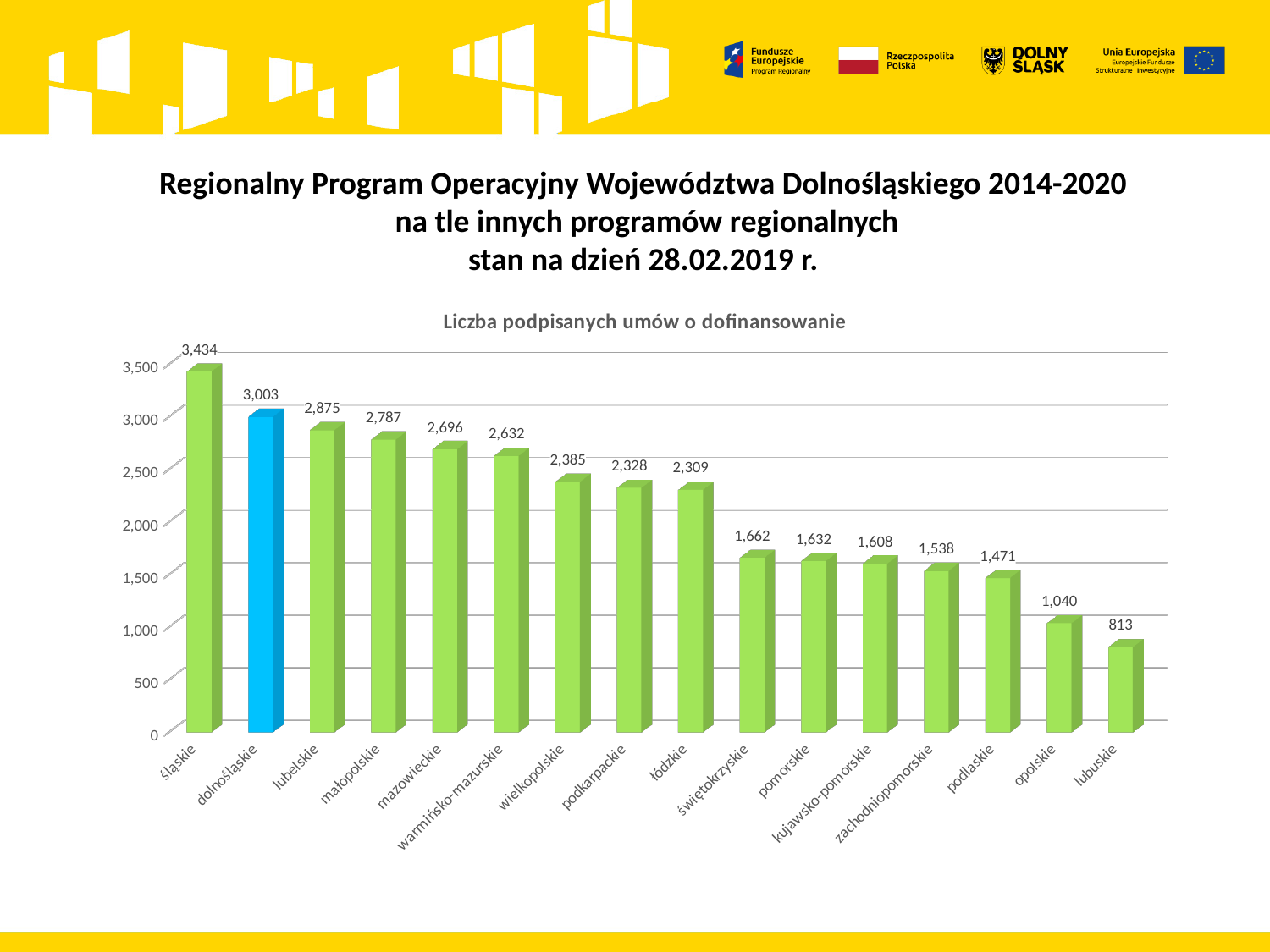
What is the difference between the values for śląskie and dolnośląskie? 431 What kind of chart is shown on the slide? bar chart Which is larger, the value for pomorskie or the value for zachodniopomorskie? pomorskie Which category has the highest value? śląskie Which category has the lowest value? lubuskie Is the value for mazowieckie greater or less than 2,500? greater How many categories are shown on the x axis? 16 What is the value for opolskie? 1,040 What is the value for dolnośląskie? 3,003 What is the value for wielkopolskie? 2,385 Do the values rise or fall from left to right along the x axis? fall What is the difference between the values for podlaskie and lubuskie? 658